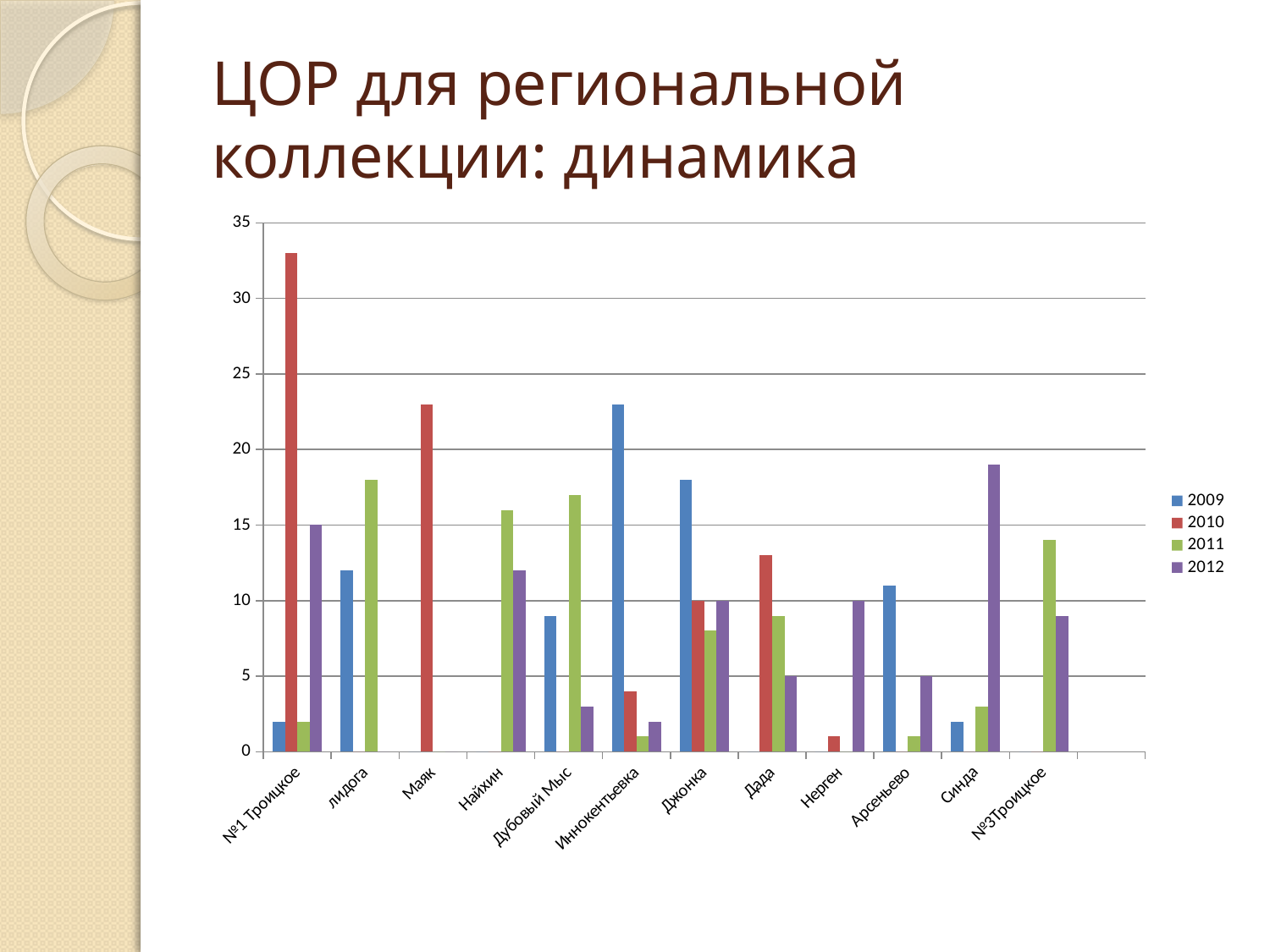
Which category has the highest value for 2009? Иннокентьевка How many series does the legend list? 4 Is the value for 2010 for Маяк greater or less than 20? greater Which is larger: the 2009 value for Джонка or the 2010 value for Дада? the 2009 value for Джонка Is the value for 2010 for Нерген greater or less than 5? less Which category has the highest value for 2010? №1 Троицкое Which category has the highest value for 2012? Синда What is the value for 2012 for Нерген? 10 What is the value for 2012 for Дада? 5 What is the value for 2012 for №1 Троицкое? 15 What kind of chart is shown on the slide? bar chart How many categories are shown on the x axis? 12